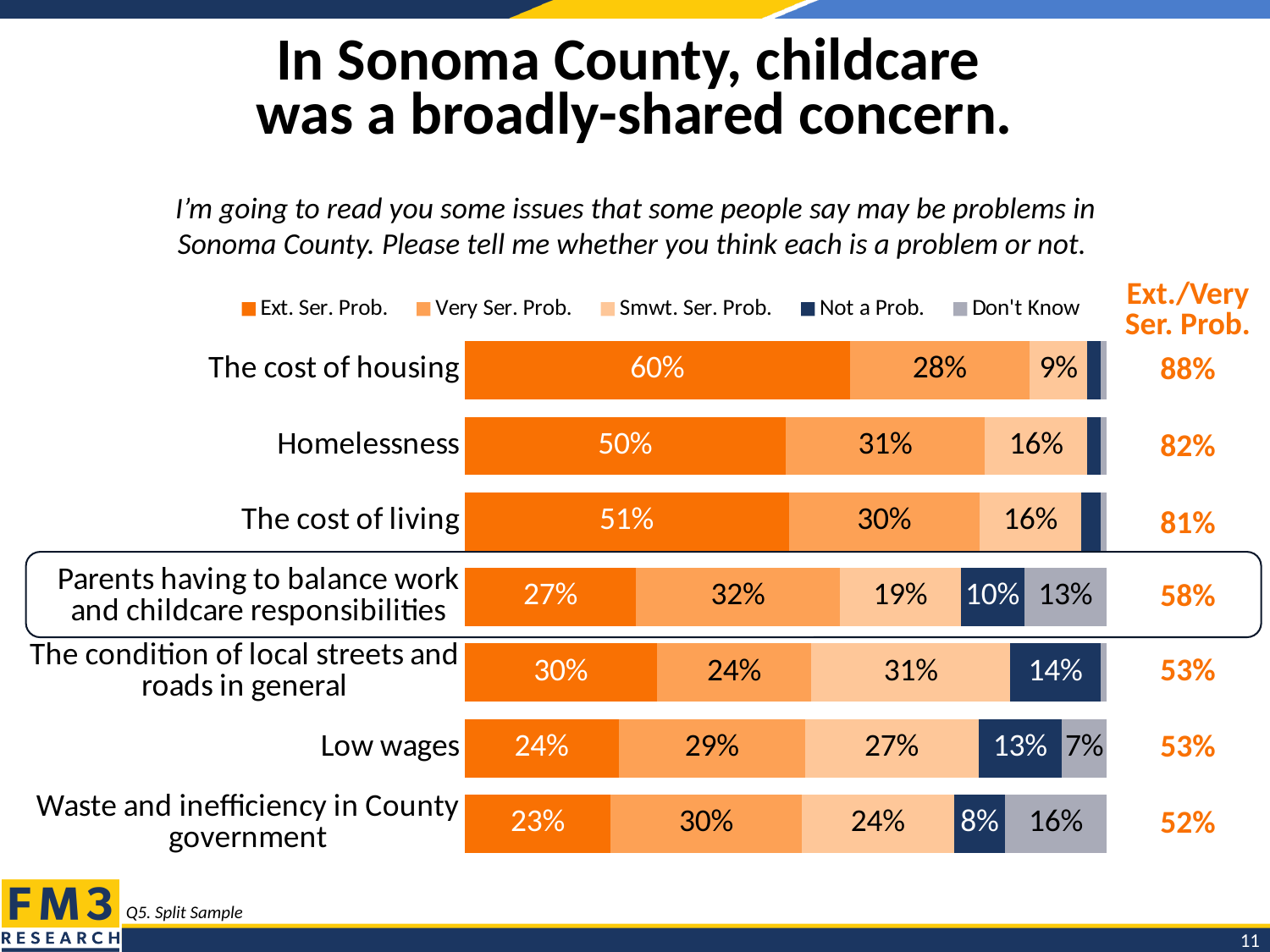
Which has a larger Very Ser. Prob. value: Low wages or The condition of local streets and roads in general? Low wages Which issue has the lowest Ext./Very Ser. Prob. combined percentage? Waste and inefficiency in County government How many issues are listed in the chart? 7 What type of chart is shown on the slide? Stacked bar chart What is the total of all segments in the Low wages bar? 100% How many series does the legend list? 5 Which issue has the highest Ext./Very Ser. Prob. combined percentage? The cost of housing How many percentage points higher is the Ext. Ser. Prob. value for the cost of housing than for Homelessness? 10 percentage points What share of respondents answered Don't Know for 'Waste and inefficiency in County government'? 16% What is the Ext./Very Ser. Prob. combined figure for Homelessness? 82% What percentage said 'Parents having to balance work and childcare responsibilities' is not a problem? 10% What percentage of respondents said the cost of housing is an extremely serious problem? 60%